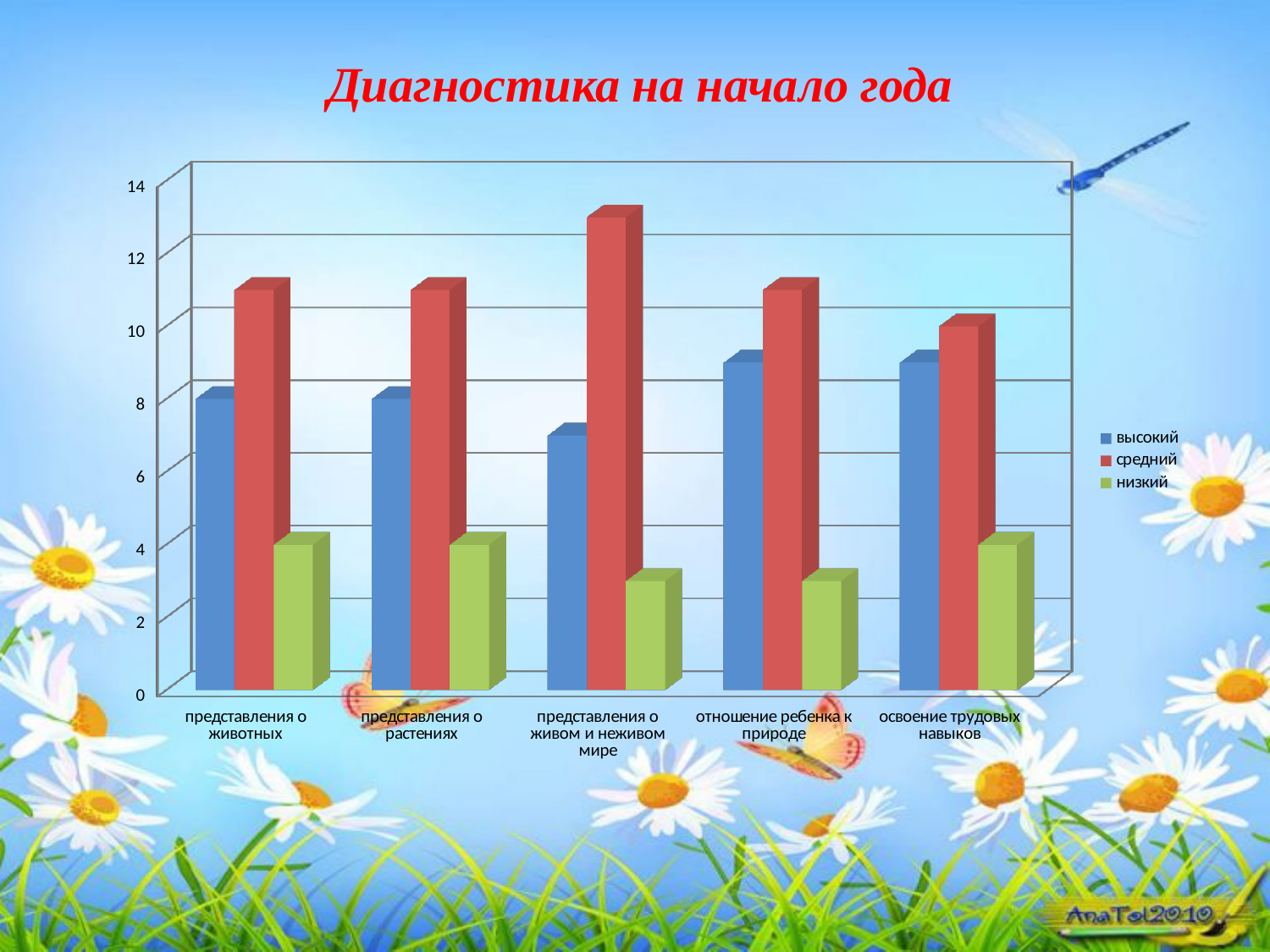
Is the "средний" value for "представления о живом и неживом мире" greater or less than 12? greater For which category is the "высокий" value lowest? представления о живом и неживом мире Which is larger: the "высокий" value for "представления о животных" or the "высокий" value for "представления о живом и неживом мире"? представления о животных What kind of chart is shown on the slide? bar chart How many categories are shown on the x axis? 5 How many series does the legend list? 3 Which colour represents the series "средний" in the legend? red For "отношение ребенка к природе", which is larger: the "высокий" value or the "средний" value? средний What is the title of the chart? Диагностика на начало года Is the "низкий" value for "освоение трудовых навыков" greater or less than 6? less For which category is the "средний" value highest? представления о живом и неживом мире Is the "высокий" value for "представления о животных" greater or less than 10? less